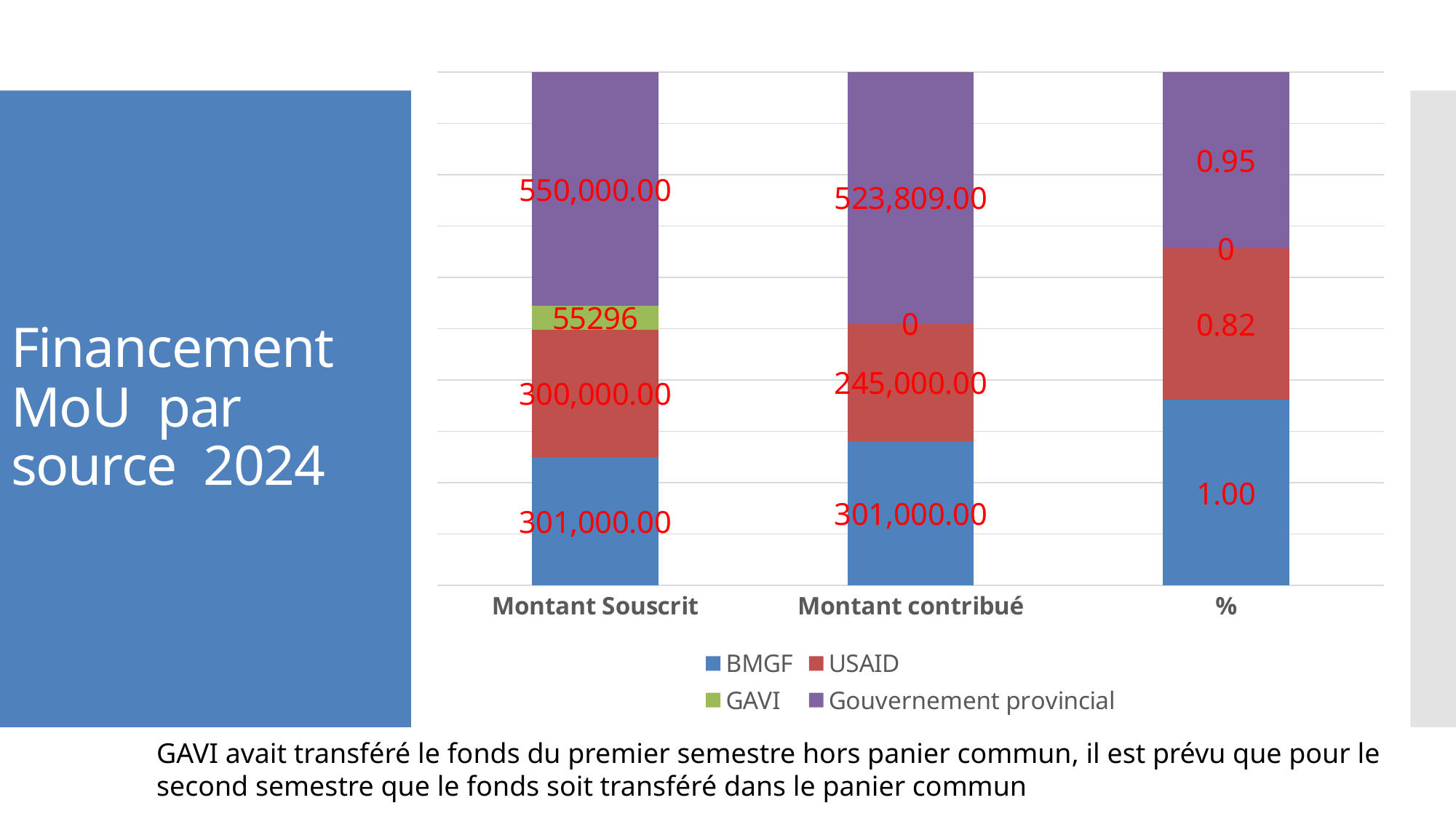
What is the value for GAVI in the Montant contribué category? 0 How many series does the legend list? 4 What is the value for BMGF in the Montant Souscrit category? 301,000.00 What is the value for GAVI in the Montant Souscrit category? 55296 What is the difference between the USAID values for Montant Souscrit and Montant contribué? 55,000.00 Which series has the highest value in the % category? BMGF What kind of chart is shown on the slide? Stacked bar chart What is the value for USAID in the % category? 0.82 What is the value for Gouvernement provincial in the Montant contribué category? 523,809.00 Which is larger: the Gouvernement provincial value for Montant Souscrit or for Montant contribué? Montant Souscrit How many categories are shown on the x axis? 3 Which colour represents USAID in the chart? Red